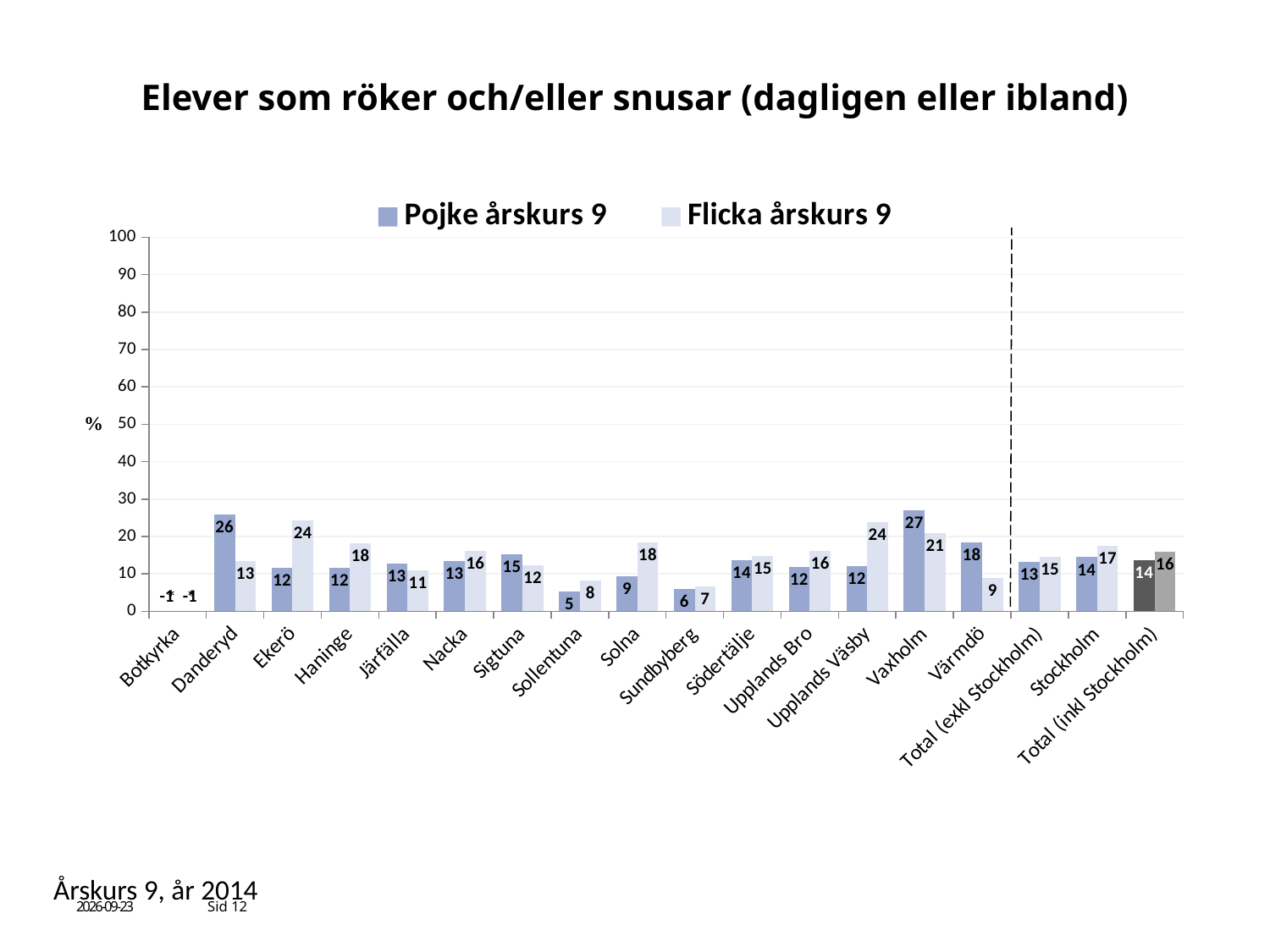
What is the value for Flicka årskurs 9 in Stockholm? 17 What is the value for Pojke årskurs 9 in Danderyd? 26 What is the value for Flicka årskurs 9 in Solna? 18 How many categories are shown on the x axis? 18 What kind of chart is shown on the slide? bar chart What is the difference between the Pojke årskurs 9 and Flicka årskurs 9 values in Vaxholm? 6 In Ekerö, which series has the larger value, Pojke årskurs 9 or Flicka årskurs 9? Flicka årskurs 9 What is the value for Pojke årskurs 9 for Total (inkl Stockholm)? 14 What is the difference between the Pojke årskurs 9 and Flicka årskurs 9 values in Danderyd? 13 Is the value for Pojke årskurs 9 in Vaxholm greater or less than 20? greater Which category has the highest value for Pojke årskurs 9? Vaxholm How many series does the legend list? 2